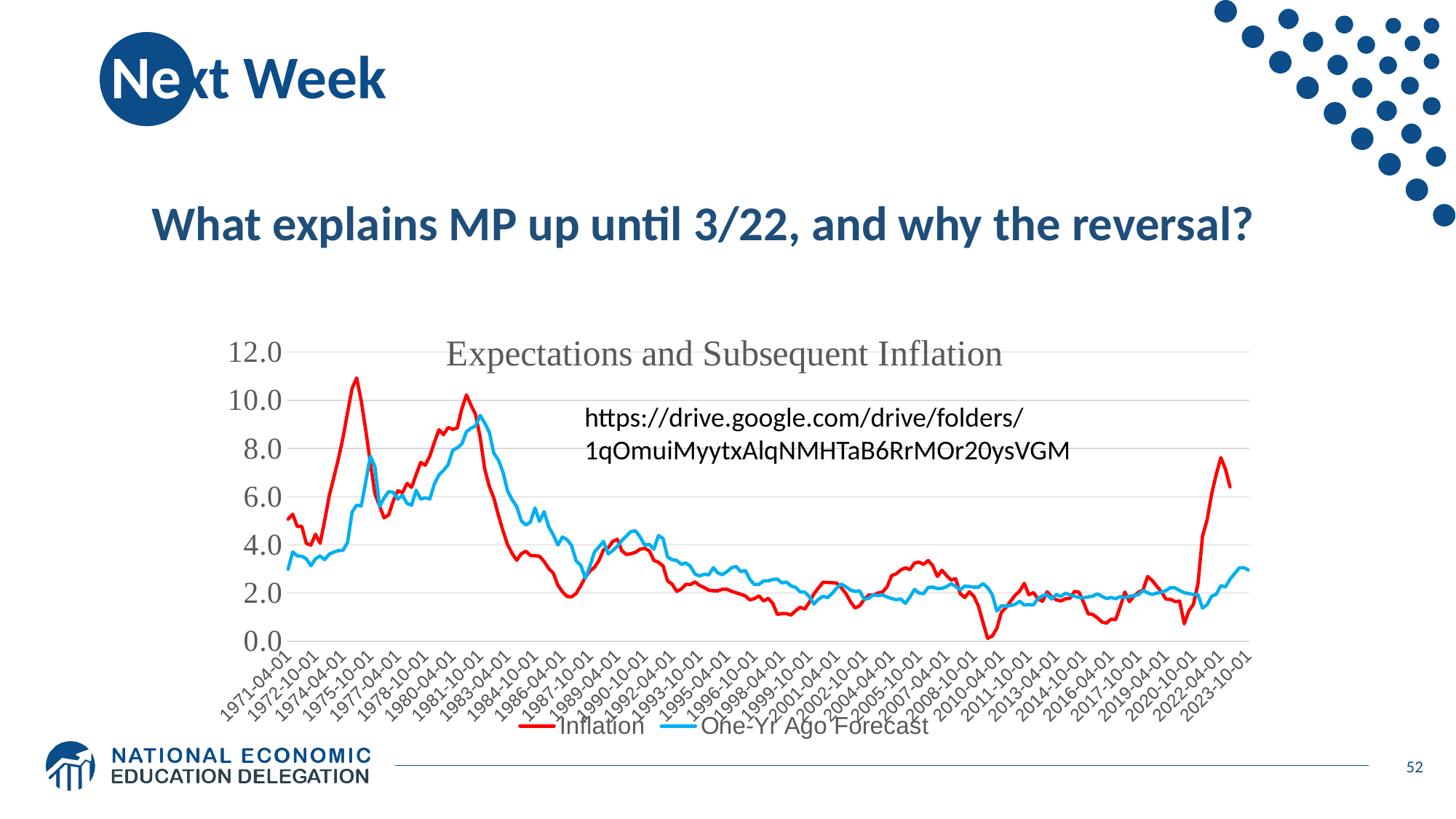
Is the lowest Inflation value around 2010 greater or less than 2.0? less Does the Inflation series generally rise or fall between 1981 and 1998? fall Is the Inflation value at its 2022 peak greater or less than 6.0? greater Does the Inflation series rise or fall between 2020-10-01 and 2022-04-01? rise Which series reaches the higher maximum value over the whole period, Inflation or One-Yr Ago Forecast? Inflation Which series is drawn in red? Inflation What kind of chart is shown on the slide? line chart Is the highest value of the One-Yr Ago Forecast series greater or less than 10.0? less What is the title of the chart? Expectations and Subsequent Inflation How many series does the chart's legend list? 2